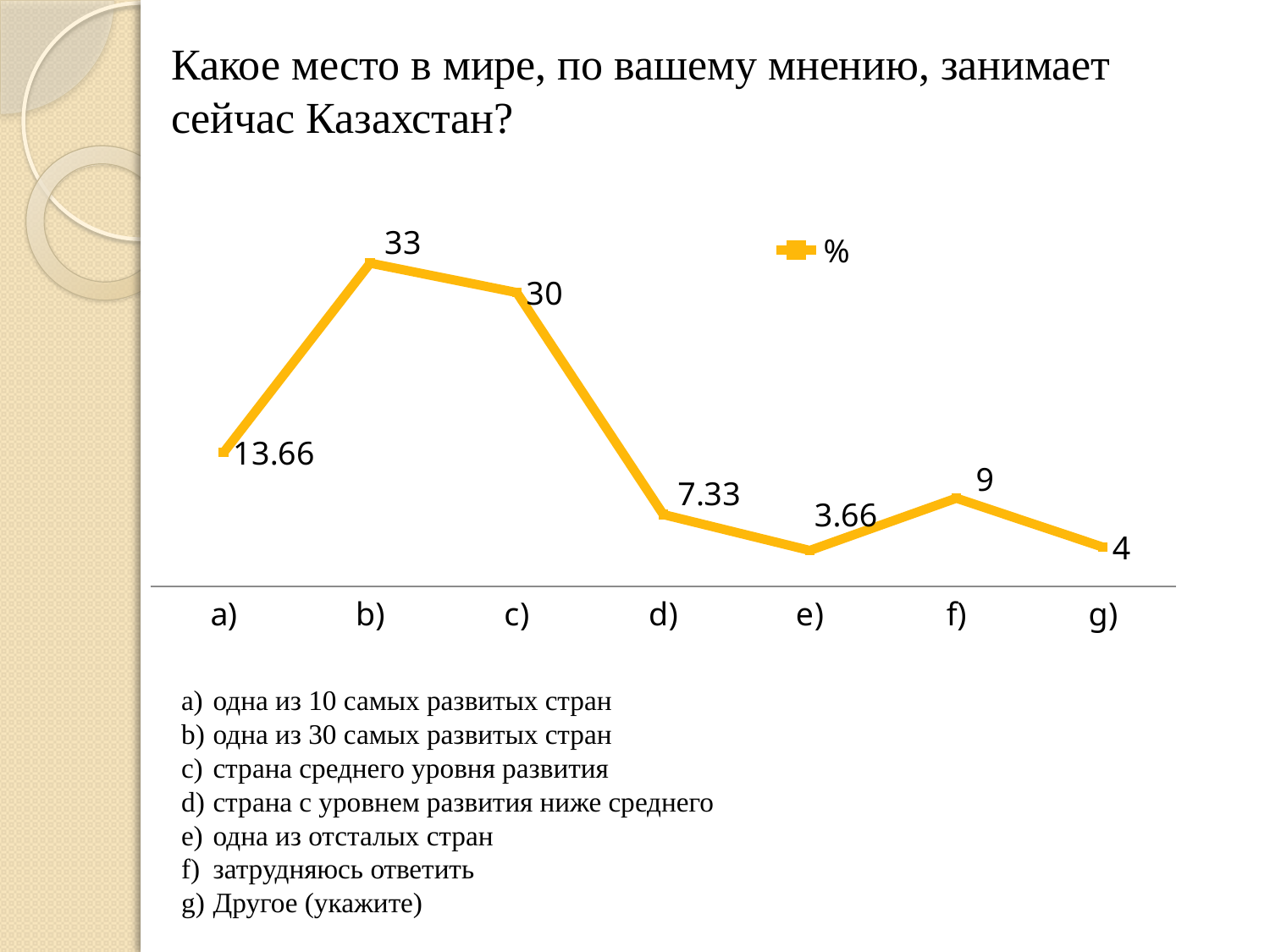
What is the difference between the values for a) and d)? 6.33 Which is larger, the value for f) or the value for g)? f) What kind of chart is shown on the slide? line chart How many categories are plotted on the x axis? 7 Which category has the highest value? b) Which category has the lowest value? e) What is the value for category g)? 4 What is the value for category a)? 13.66 What is the value for category e)? 3.66 What is the name of the series shown in the legend? % What is the difference between the values for b) and c)? 3 What is the value for category b)? 33